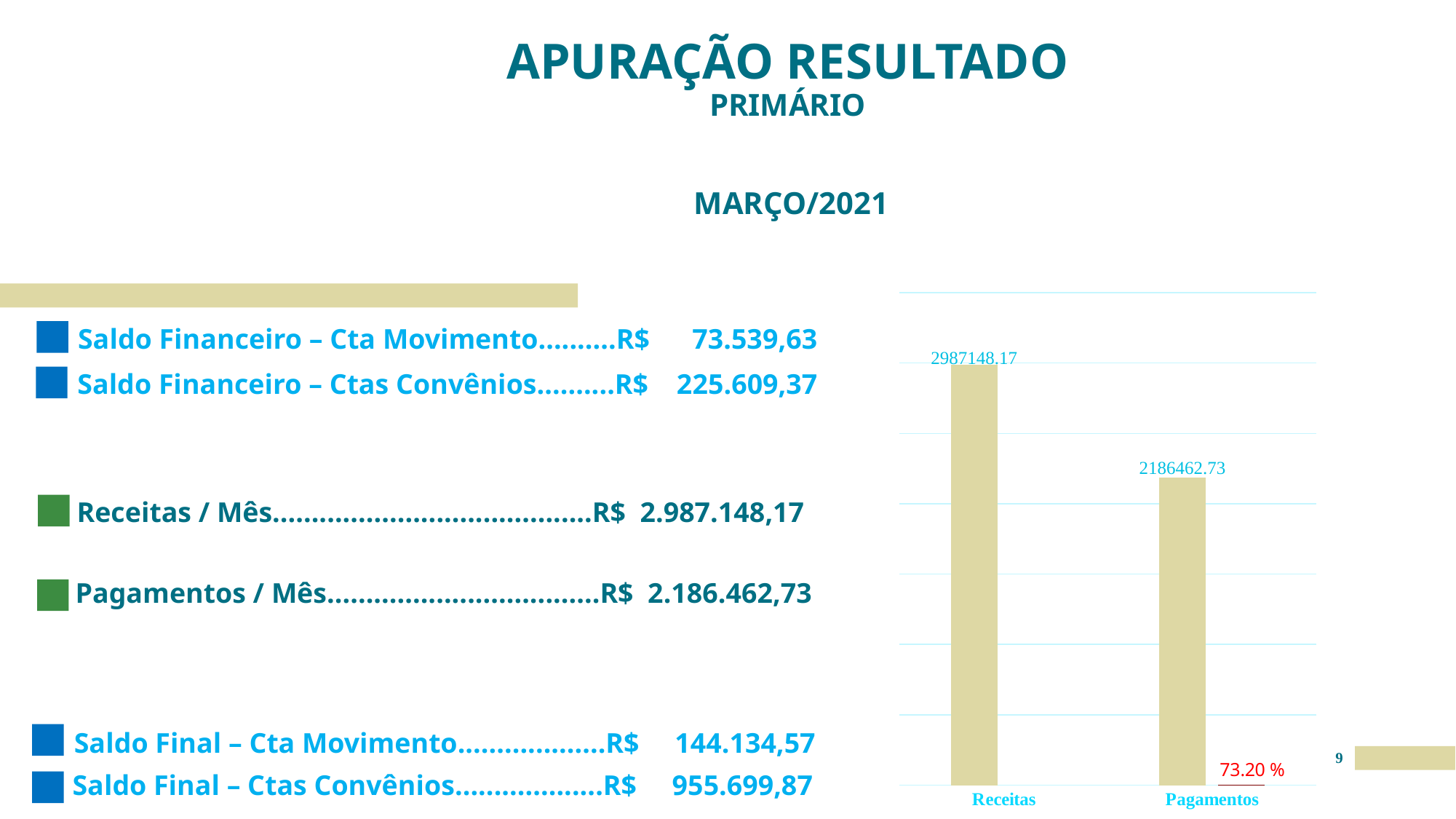
Which category has the highest bar in the chart? Receitas What type of chart is shown on the slide? bar chart Which is larger in the chart, Receitas or Pagamentos? Receitas What is the value of the Receitas bar in the chart? 2987148.17 Do the values rise or fall from Receitas to Pagamentos along the x axis? fall How many bars are plotted in the chart? 2 What percentage is printed in red next to the Pagamentos bar? 73.20 % Which category has the lowest bar in the chart? Pagamentos What is the value of the Pagamentos bar in the chart? 2186462.73 What are the category labels on the x axis of the chart? Receitas, Pagamentos What is the difference between the Receitas and Pagamentos values in the chart? 800685.44